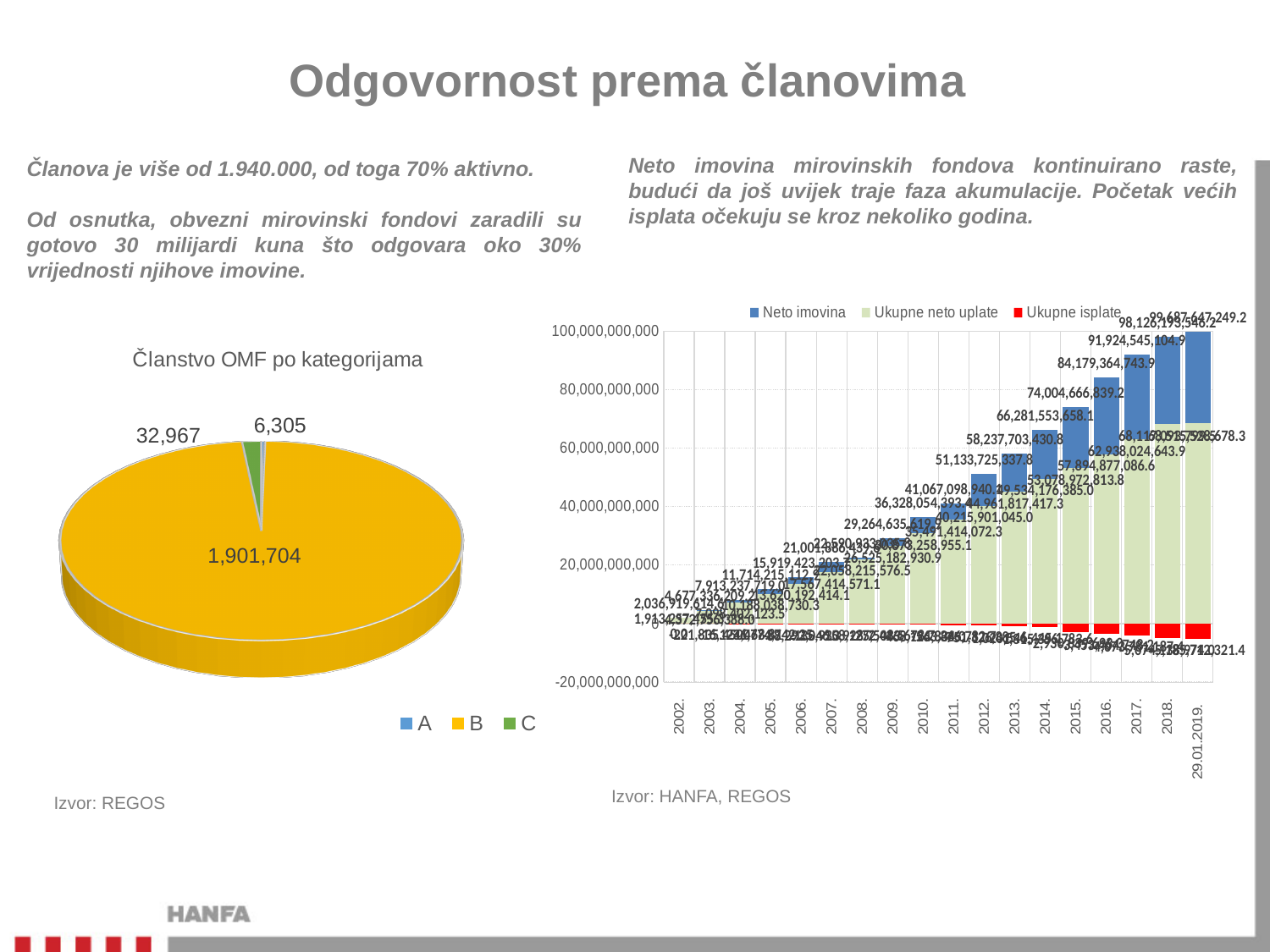
What kind of chart is the chart on the right of the slide? bar chart What kind of chart is the chart titled 'Članstvo OMF po kategorijama'? pie chart In the pie chart 'Članstvo OMF po kategorijama', what is the value for category C? 32,967 How many categories does the pie chart 'Članstvo OMF po kategorijama' show? 3 In the pie chart 'Članstvo OMF po kategorijama', which category has the smallest value? A In the pie chart 'Članstvo OMF po kategorijama', which colour represents category B? yellow In the pie chart 'Članstvo OMF po kategorijama', what is the value for category B? 1,901,704 In the bar chart on the right, does the 'Neto imovina' series rise or fall from 2002 to 29.01.2019? rise In the pie chart 'Članstvo OMF po kategorijama', what is the value for category A? 6,305 In the pie chart 'Članstvo OMF po kategorijama', what is the difference between the values for A and C? 26,662 In the bar chart on the right, is the 'Neto imovina' value for 2018 greater or less than 80,000,000,000? greater How many series does the legend of the bar chart on the right list? 3